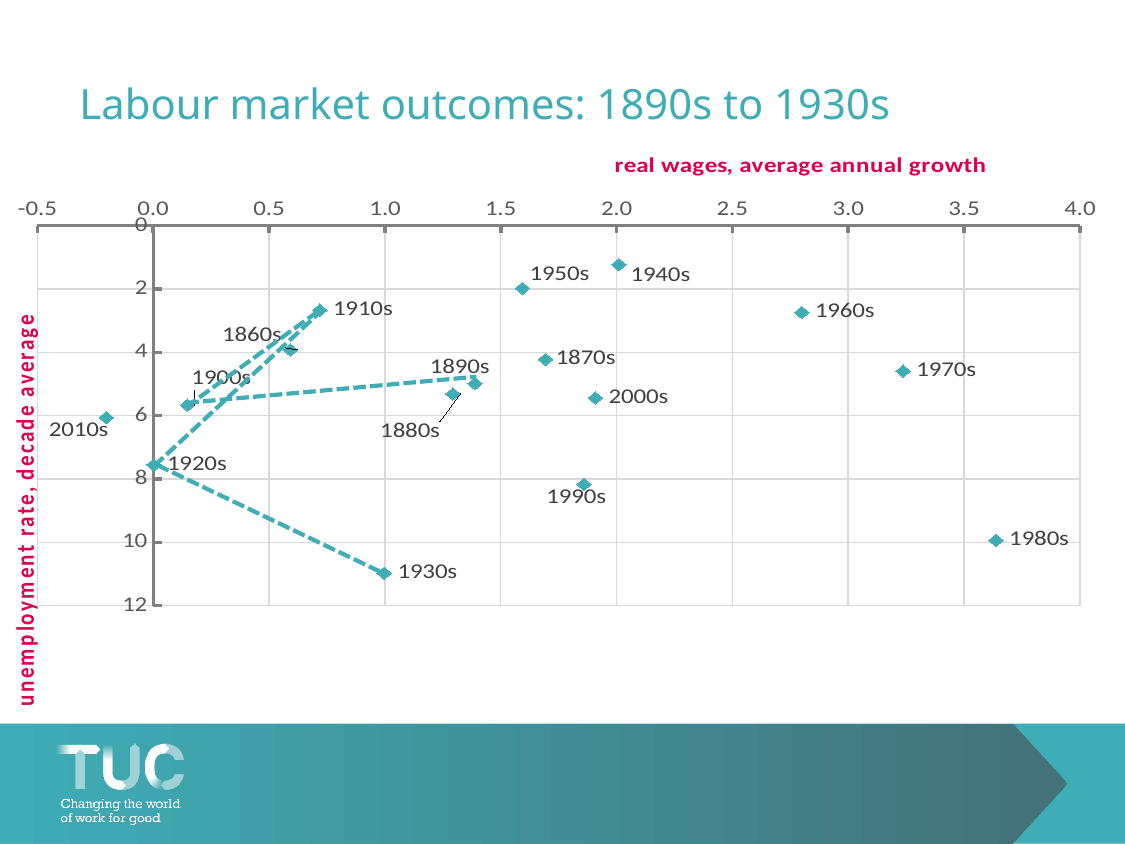
What kind of chart is shown on the slide? scatter chart What is the title of the chart? Labour market outcomes: 1890s to 1930s Which decade has the lowest real wages average annual growth? 2010s Is the unemployment rate for the 1930s greater or less than 10? greater How many decade points are plotted on the chart? 16 What does the vertical axis of the chart represent? unemployment rate, decade average Which decade has the highest real wages average annual growth? 1980s Which decade has the lowest unemployment rate on the chart? 1940s Which decade has the higher real wages average annual growth, the 1960s or the 1970s? 1970s Is the real wages average annual growth for the 2010s greater or less than 0.0? less Which decade has the highest unemployment rate on the chart? 1930s Is the real wages average annual growth for the 1980s greater or less than 3.5? greater